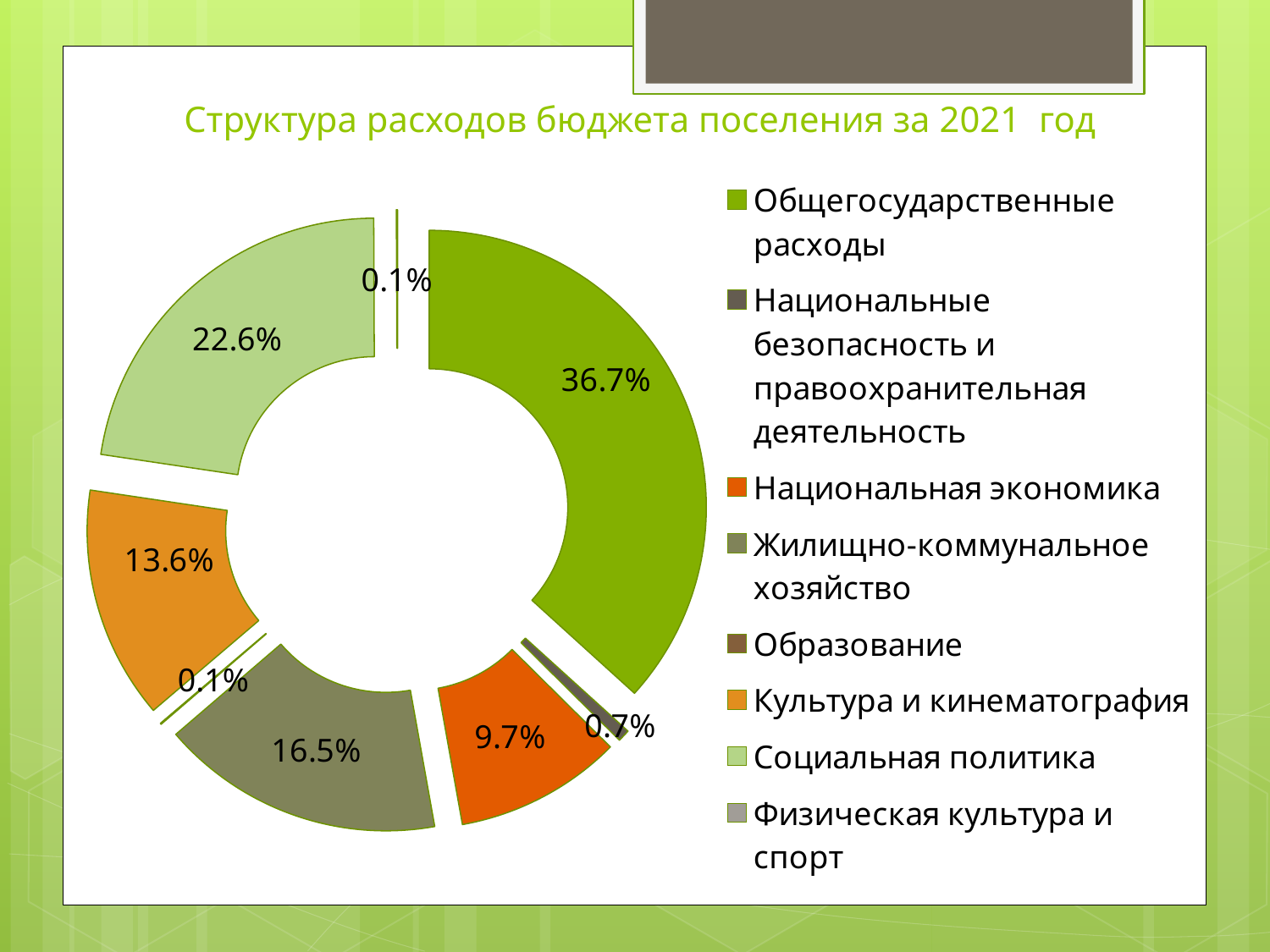
What type of chart is shown on the slide? Doughnut (pie) chart What is the title of the chart? Структура расходов бюджета поселения за 2021 год What share of the budget expenditures is Культура и кинематография? 13.6% What share of the budget expenditures is Социальная политика? 22.6% What share of the budget expenditures is Национальная экономика? 9.7% What share of the budget expenditures is Общегосударственные расходы? 36.7% How many categories does the legend list? 8 Which expenditure category has the largest share? Общегосударственные расходы What share of the budget expenditures is Национальная безопасность и правоохранительная деятельность? 0.7% Which has a larger share: Жилищно-коммунальное хозяйство or Культура и кинематография? Жилищно-коммунальное хозяйство What share of the budget expenditures is Жилищно-коммунальное хозяйство? 16.5% What is the difference between the shares of Общегосударственные расходы and Социальная политика? 14.1%